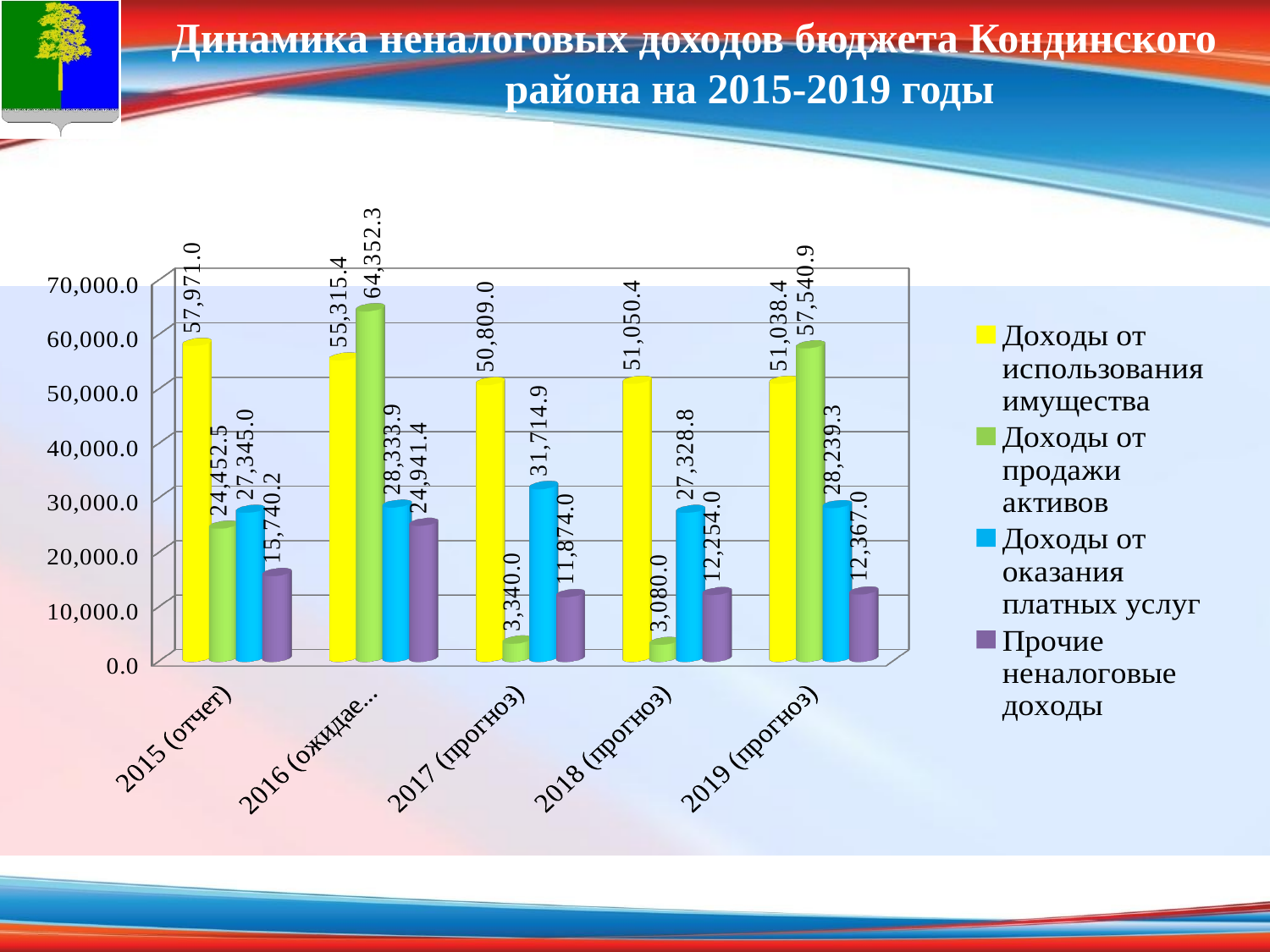
What is the difference between Доходы от оказания платных услуг and Прочие неналоговые доходы in 2017 (прогноз)? 19,840.9 What is the value of Доходы от продажи активов for 2016? 64,352.3 How many year categories are shown on the x axis? 5 What is the value of Доходы от использования имущества for 2015 (отчет)? 57,971.0 How many series does the legend list? 4 What is the value of Прочие неналоговые доходы for 2019 (прогноз)? 12,367.0 What is the value of Доходы от оказания платных услуг for 2017 (прогноз)? 31,714.9 What kind of chart is shown on the slide? Bar chart In which year is Доходы от продажи активов the lowest? 2018 (прогноз) In which year is Доходы от продажи активов the highest? 2016 In 2019 (прогноз), which is larger: Доходы от использования имущества or Доходы от продажи активов? Доходы от продажи активов What is the difference between Доходы от продажи активов and Доходы от использования имущества in 2016? 9,036.9